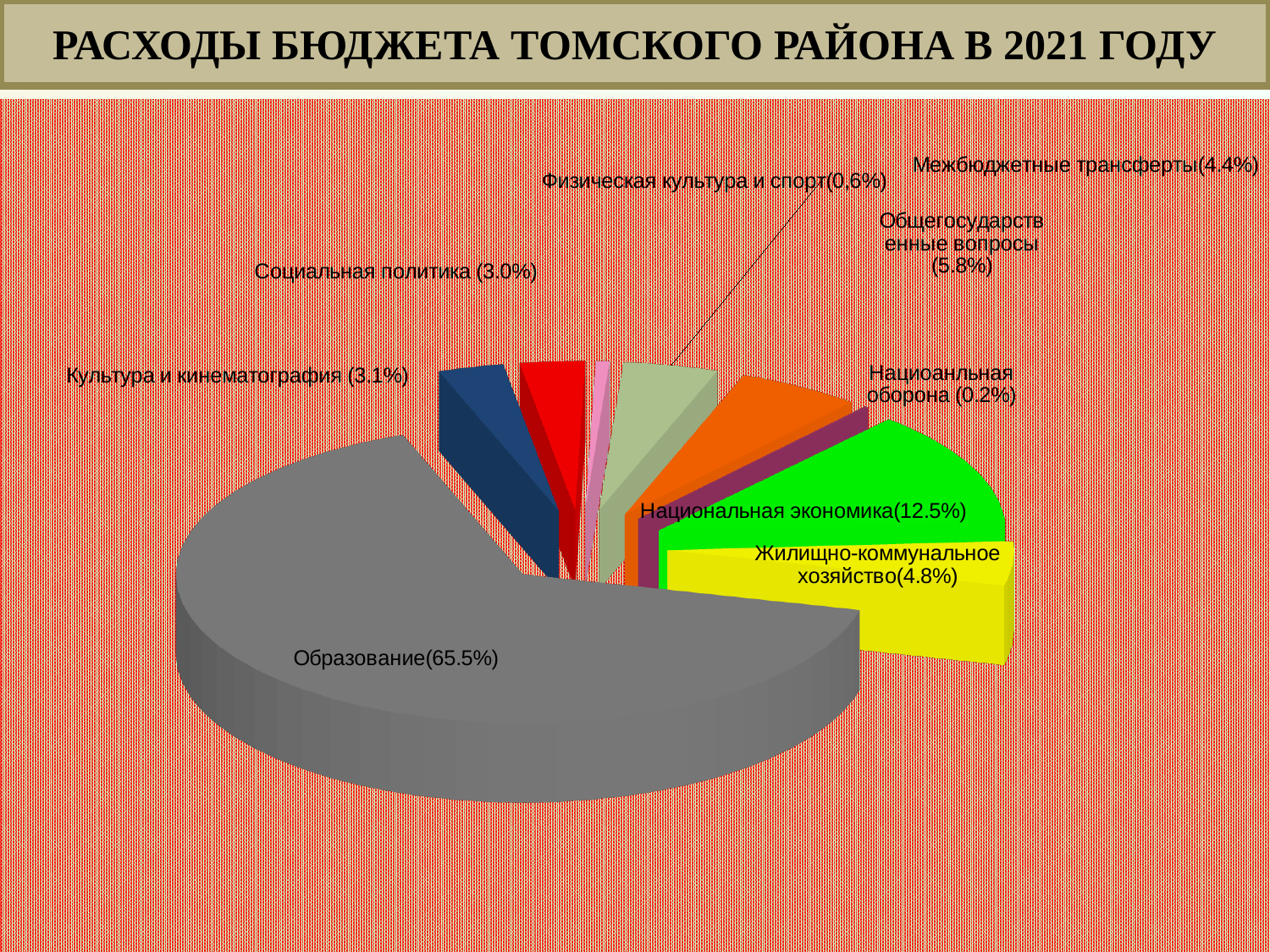
How many categories are shown in the pie chart? 9 Which category has the largest share of the pie? Образование What share is shown for Национальная экономика? 12.5% What share is shown for Жилищно-коммунальное хозяйство? 4.8% What kind of chart is shown on the slide? Pie chart What share is shown for Межбюджетные трансферты? 4.4% What share of the budget expenditure goes to Образование? 65.5% What share is shown for Общегосударственные вопросы? 5.8% Which category has the smallest share of the pie? Национальная оборона Which is larger: the share for Социальная политика or for Культура и кинематография? Культура и кинематография What is the difference in percentage points between Образование and Национальная экономика? 53.0 What is the title of the slide? РАСХОДЫ БЮДЖЕТА ТОМСКОГО РАЙОНА В 2021 ГОДУ